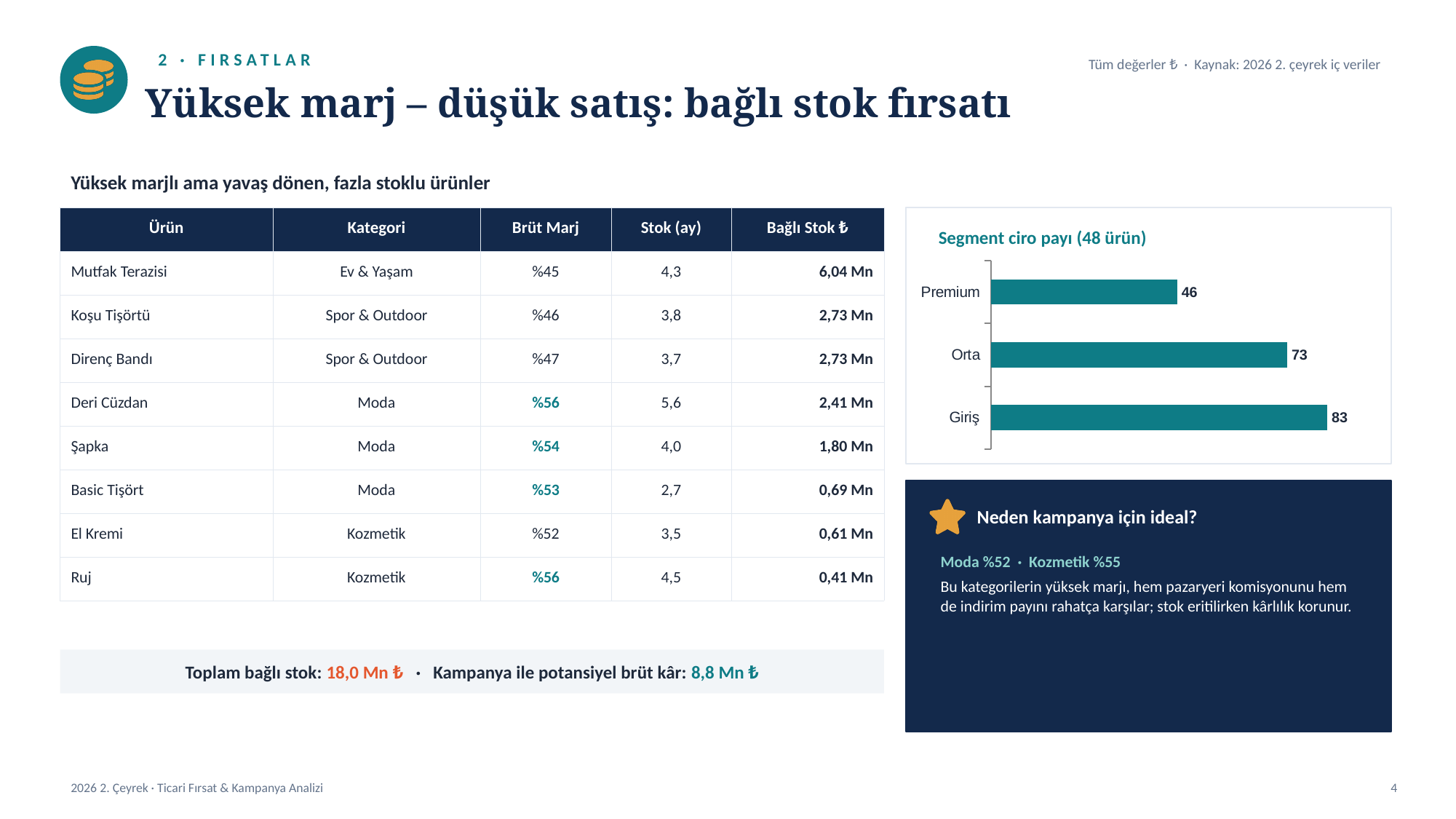
How many segments are shown in the 'Segment ciro payı (48 ürün)' chart? 3 Which segment has the lowest value in the 'Segment ciro payı (48 ürün)' chart? Premium Which segment has the highest value in the 'Segment ciro payı (48 ürün)' chart? Giriş What kind of chart is 'Segment ciro payı (48 ürün)'? Bar chart What is the value for Premium in the 'Segment ciro payı (48 ürün)' chart? 46 What is the difference between the Giriş and Premium values in the 'Segment ciro payı (48 ürün)' chart? 37 What is the title of the chart on the right side of the slide? Segment ciro payı (48 ürün) What is the value for Giriş in the 'Segment ciro payı (48 ürün)' chart? 83 What is the difference between the Orta and Premium values in the 'Segment ciro payı (48 ürün)' chart? 27 In the 'Segment ciro payı (48 ürün)' chart, which is larger: Giriş or Orta? Giriş What is the value for Orta in the 'Segment ciro payı (48 ürün)' chart? 73 In the 'Segment ciro payı (48 ürün)' chart, which is larger: Orta or Premium? Orta